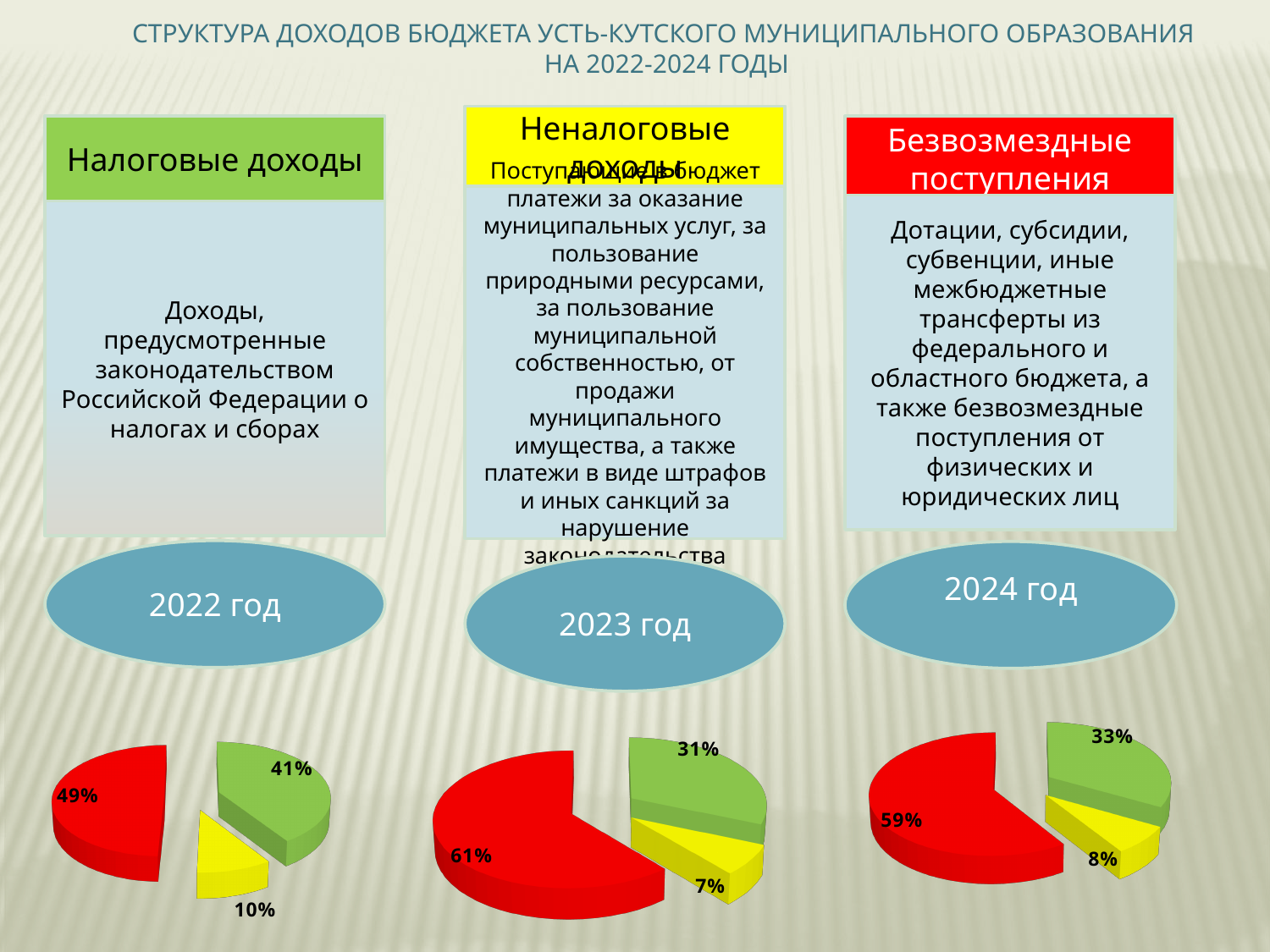
How many slices does each pie chart on the slide have? 3 In the 2023 год pie chart, which slice is the largest? the red slice (Безвозмездные поступления), 61% In the 2023 год pie chart, what share is shown for the yellow slice (Неналоговые доходы)? 7% Which is larger in the 2024 год pie chart: the green slice (Налоговые доходы) or the yellow slice (Неналоговые доходы)? the green slice (33%) In the 2022 год pie chart, what is the difference between the red slice (49%) and the green slice (41%)? 8 percentage points In the 2024 год pie chart, which slice is the smallest? the yellow slice (Неналоговые доходы), 8% What kind of chart is used to show the 2022 год budget revenue structure? pie chart How does the share of the red slice (Безвозмездные поступления) change from the 2022 год chart to the 2023 год chart? it rises from 49% to 61% In the 2022 год pie chart, what share is shown for the red slice (Безвозмездные поступления)? 49% In the 2024 год pie chart, what share is shown for the red slice (Безвозмездные поступления)? 59% How many pie charts are shown on the slide? 3 In the 2022 год pie chart, what share is shown for the green slice (Налоговые доходы)? 41%